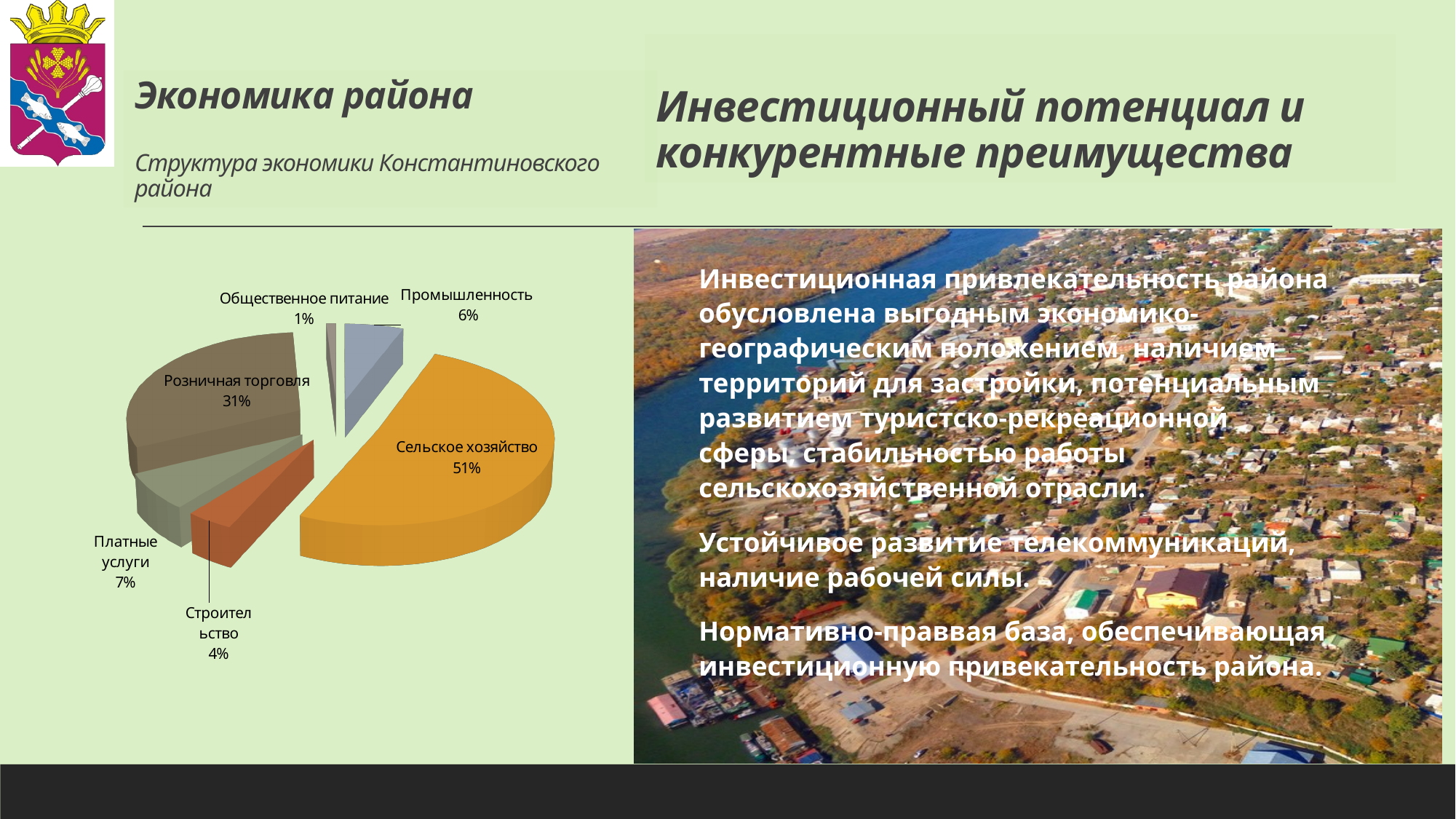
What is the value shown for Розничная торговля? 31% What colour is the Сельское хозяйство slice? Orange How many categories are shown in the pie chart? 6 Which category has the smallest slice of the pie? Общественное питание What share of the pie does Сельское хозяйство hold? 51% Which is larger, Платные услуги or Строительство? Платные услуги What is the combined share of Промышленность and Строительство? 10% Which category has the largest slice of the pie? Сельское хозяйство What is the value for Промышленность? 6% What percentage is shown for Платные услуги? 7% What is the difference in percentage points between Сельское хозяйство and Розничная торговля? 20 What kind of chart is shown on the slide? Pie chart